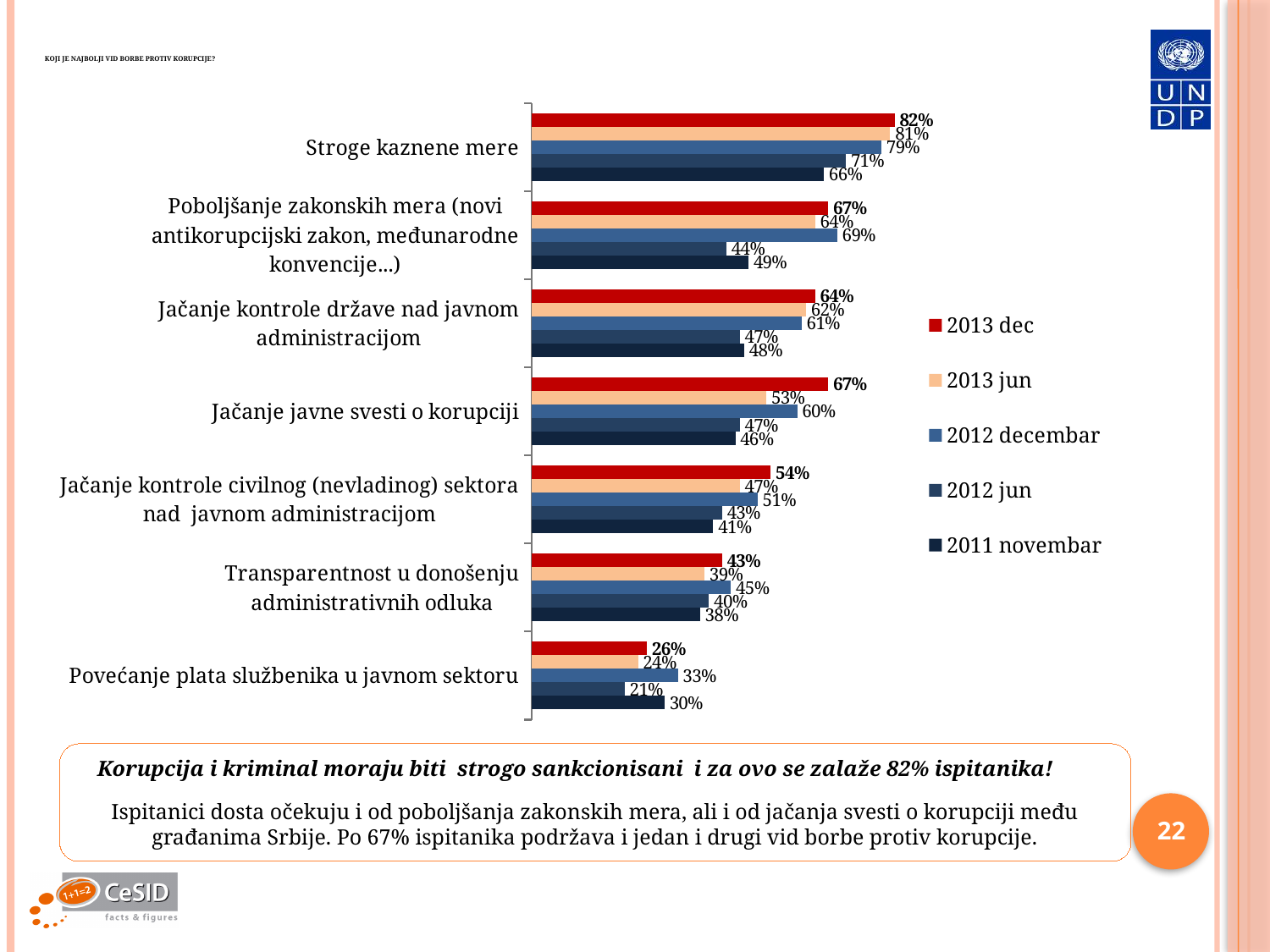
What is the value for "Jačanje javne svesti o korupciji" in the 2013 jun series? 53% Which series is shown in red in the legend? 2013 dec Which category has the lowest value in the 2011 novembar series? Povećanje plata službenika u javnom sektoru How many categories are shown on the chart? 7 How many series does the legend list? 5 Which category has the highest value in the 2013 dec series? Stroge kaznene mere For "Poboljšanje zakonskih mera (novi antikorupcijski zakon, međunarodne konvencije...)", which is larger: the 2013 dec value or the 2012 decembar value? 2012 decembar What is the value for "Stroge kaznene mere" in the 2013 dec series? 82% What is the difference between the 2013 dec and 2011 novembar values for "Stroge kaznene mere"? 16% What is the value for "Transparentnost u donošenju administrativnih odluka" in the 2012 jun series? 40% What kind of chart is shown on the slide? Bar chart What is the value for "Povećanje plata službenika u javnom sektoru" in the 2012 decembar series? 33%